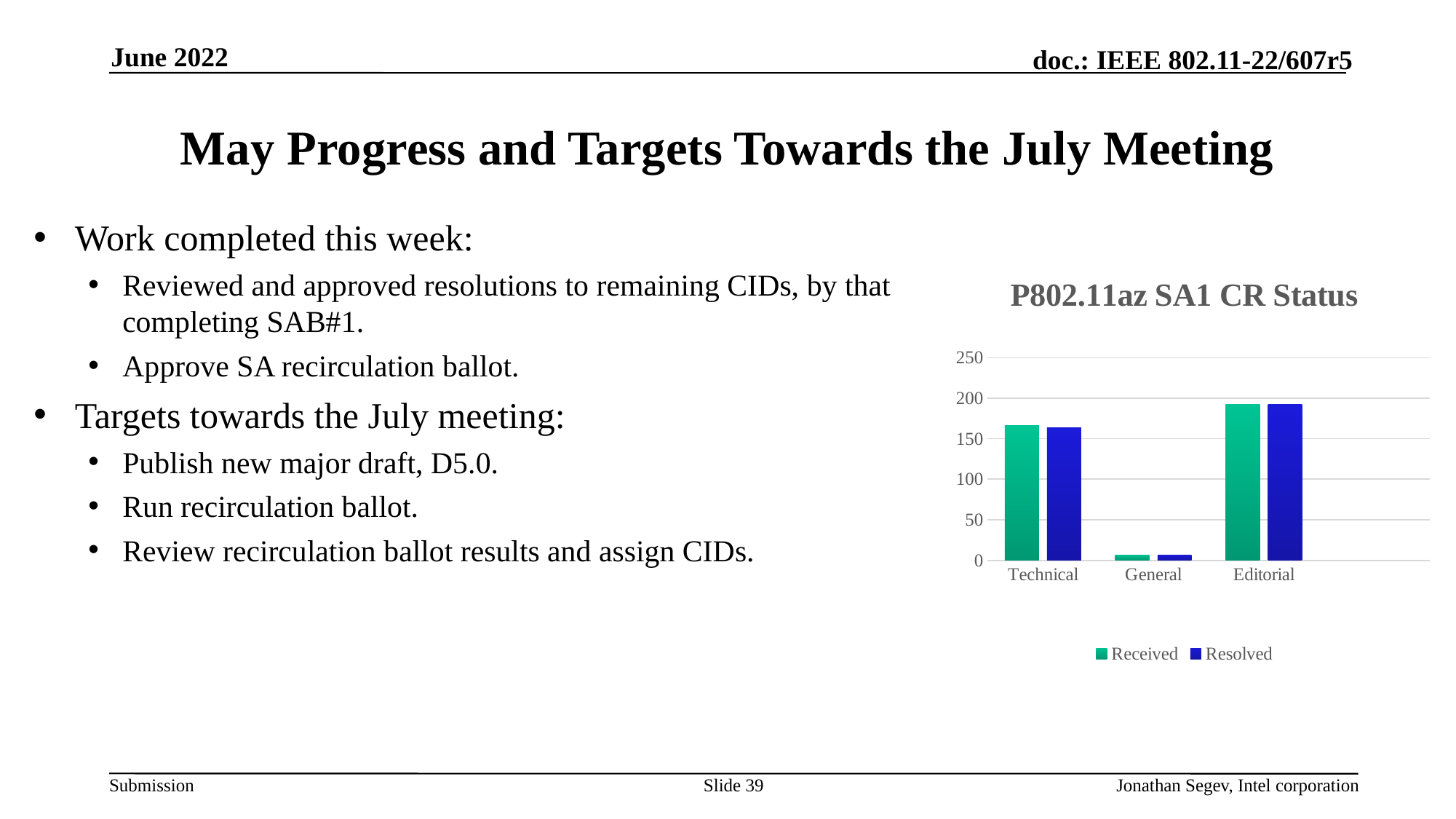
Which category has the lowest Resolved value? General Is the Received value for Editorial greater or less than 200? less Which is larger, the Received value for Technical or the Received value for Editorial? Editorial Which category has the highest Received value? Editorial How many categories are shown on the x axis of the chart? 3 Is the Received value for Technical greater or less than 150? greater What kind of chart is shown on the slide? bar chart What is the title of the chart on the slide? P802.11az SA1 CR Status How many series does the chart's legend list? 2 Is the Resolved value for Editorial greater or less than 150? greater Which series is shown in blue in the chart? Resolved